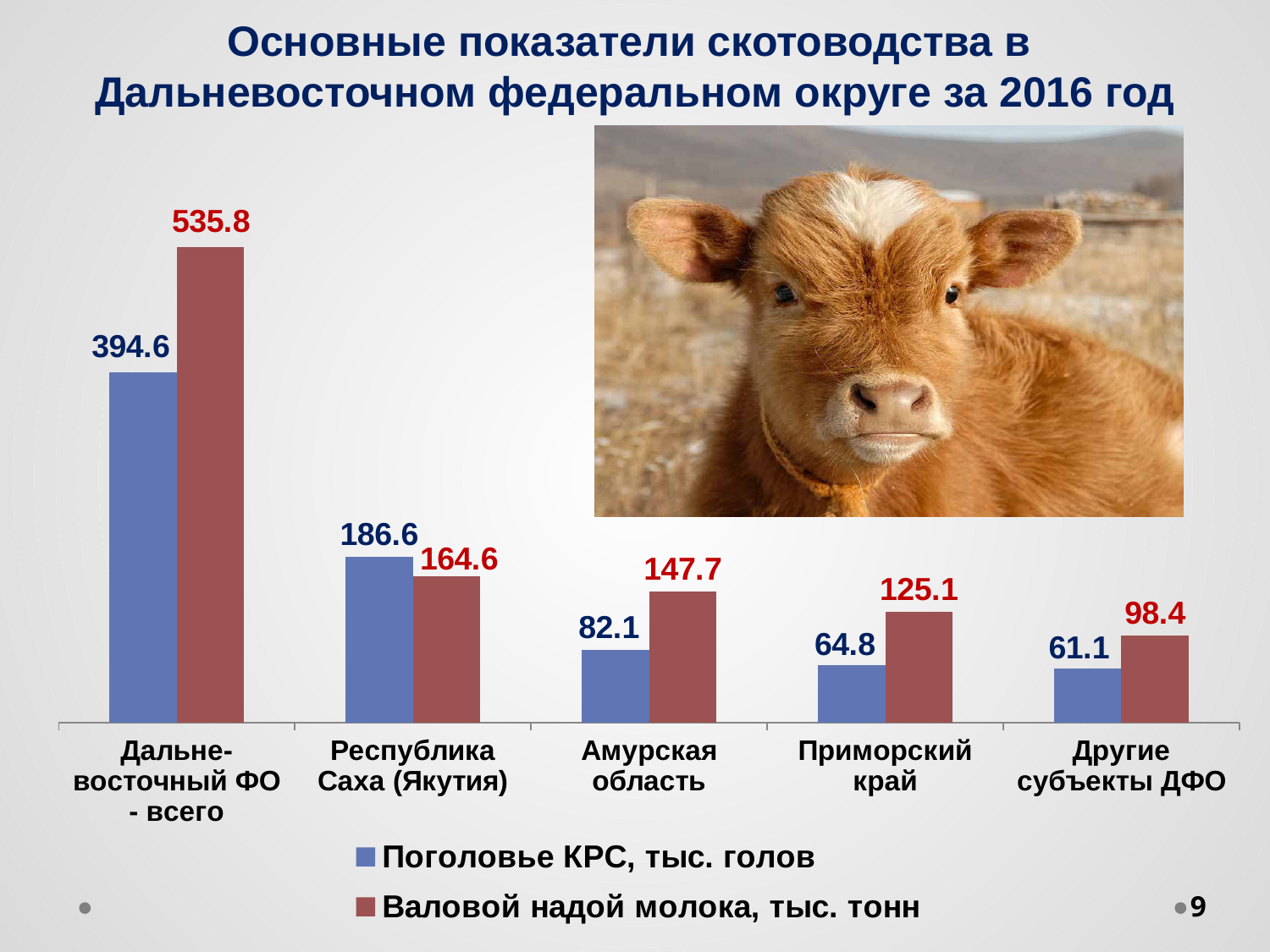
What is the difference between Валовой надой молока and Поголовье КРС for Дальневосточный ФО - всего? 141.2 Which category has the lowest value for Валовой надой молока, тыс. тонн? Другие субъекты ДФО How many categories are shown on the x axis? 5 What is the value of Валовой надой молока, тыс. тонн for Приморский край? 125.1 Which colour represents Валовой надой молока, тыс. тонн in the chart? Red How many series does the legend list? 2 What is the value of Валовой надой молока, тыс. тонн for Республика Саха (Якутия)? 164.6 What kind of chart is shown on the slide? Bar chart What is the difference between Поголовье КРС for Республика Саха (Якутия) and Амурская область? 104.5 For Республика Саха (Якутия), which is larger: Поголовье КРС or Валовой надой молока? Поголовье КРС Which category has the highest value for Поголовье КРС, тыс. голов? Дальневосточный ФО - всего What is the value of Поголовье КРС, тыс. голов for Амурская область? 82.1